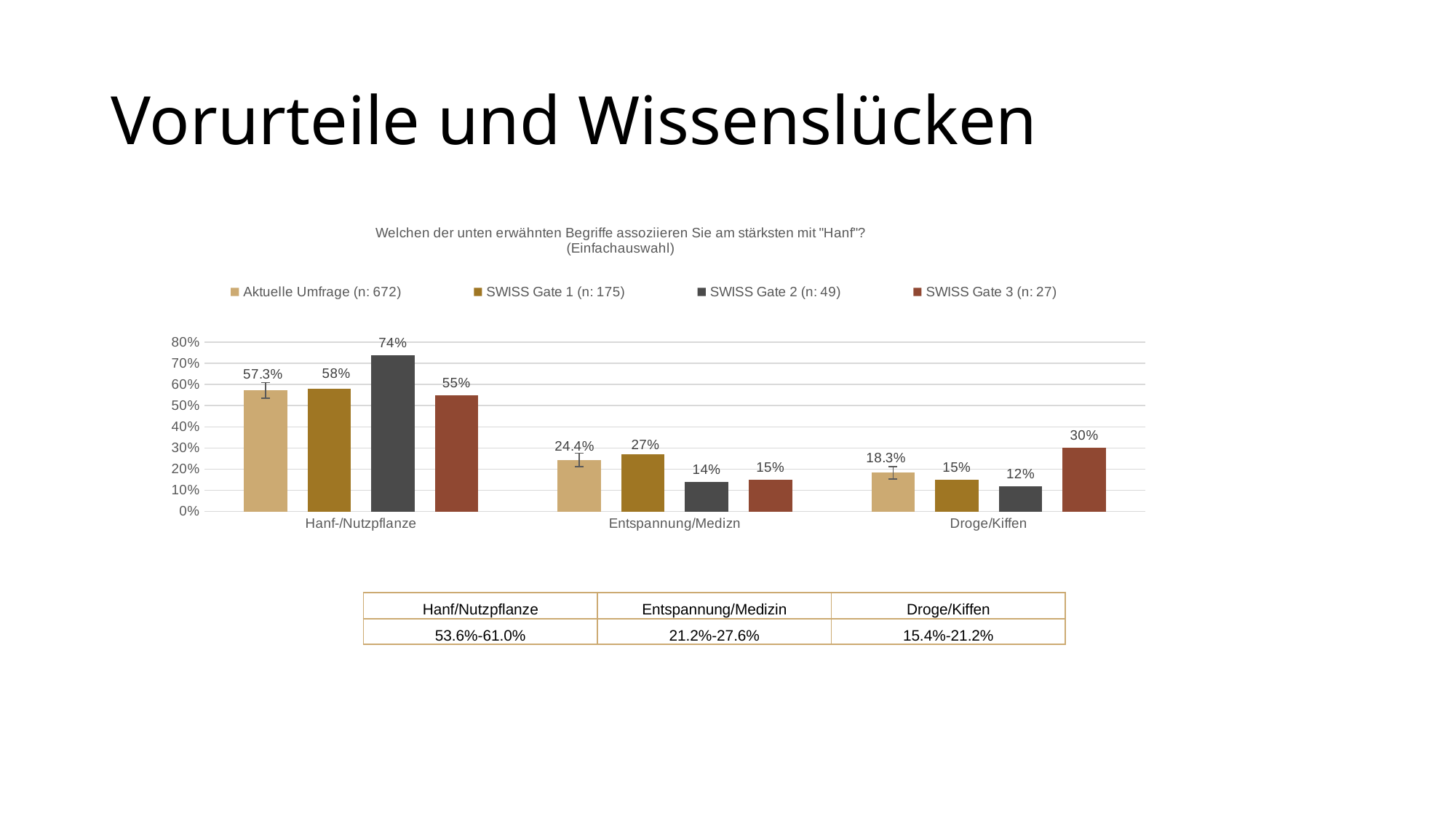
What is the value for SWISS Gate 1 (n: 175) in the Entspannung/Medizn category? 27% What is the value for Aktuelle Umfrage (n: 672) in the Hanf-/Nutzpflanze category? 57.3% How many series does the chart legend list? 4 What is the value for SWISS Gate 3 (n: 27) in the Droge/Kiffen category? 30% What kind of chart is shown on the slide? Bar chart Which series has the highest value in the Hanf-/Nutzpflanze category? SWISS Gate 2 (n: 49) Which series has the lowest value in the Droge/Kiffen category? SWISS Gate 2 (n: 49) What is the difference between the SWISS Gate 2 (n: 49) and SWISS Gate 3 (n: 27) values in the Hanf-/Nutzpflanze category? 19% What is the sample size (n) given in the legend for Aktuelle Umfrage? 672 How many categories are shown on the x axis of the chart? 3 What is the value for SWISS Gate 2 (n: 49) in the Hanf-/Nutzpflanze category? 74% Which is larger in the Droge/Kiffen category: Aktuelle Umfrage (n: 672) or SWISS Gate 1 (n: 175)? Aktuelle Umfrage (n: 672)